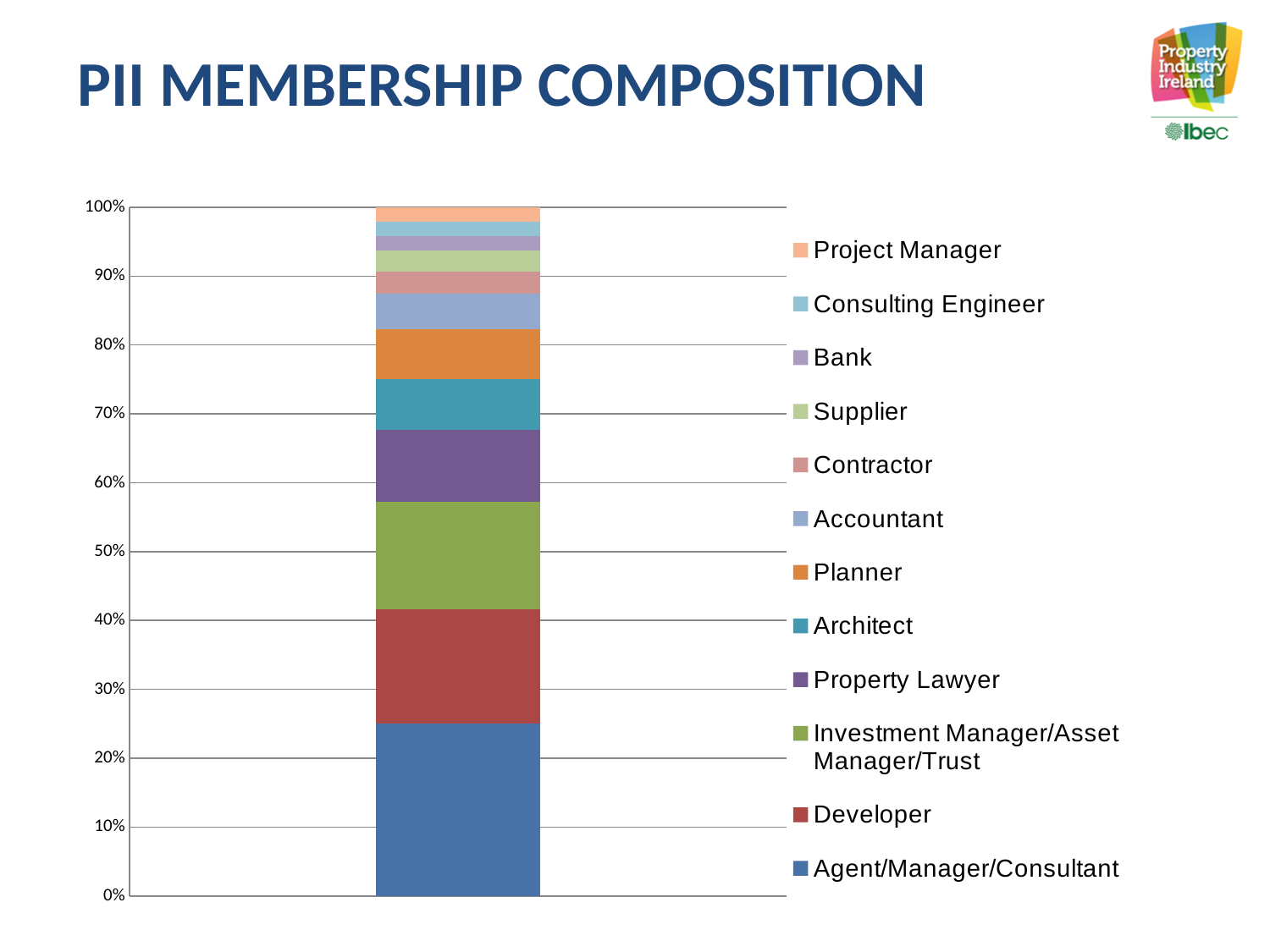
What is the title of the chart on the slide? PII MEMBERSHIP COMPOSITION Is the share for Developer greater or less than 10%? greater What kind of chart is shown on the slide? stacked bar chart Is the share for Planner greater or less than 10%? less Which has the larger share, Investment Manager/Asset Manager/Trust or Property Lawyer? Investment Manager/Asset Manager/Trust Is the share for Agent/Manager/Consultant greater or less than 20%? greater Which membership category makes up the largest share of the stacked bar? Agent/Manager/Consultant Which has the larger share, Agent/Manager/Consultant or Developer? Agent/Manager/Consultant How many series does the legend list? 12 How many stacked bars are plotted in the chart? 1 Which legend entry is listed first at the top of the legend? Project Manager